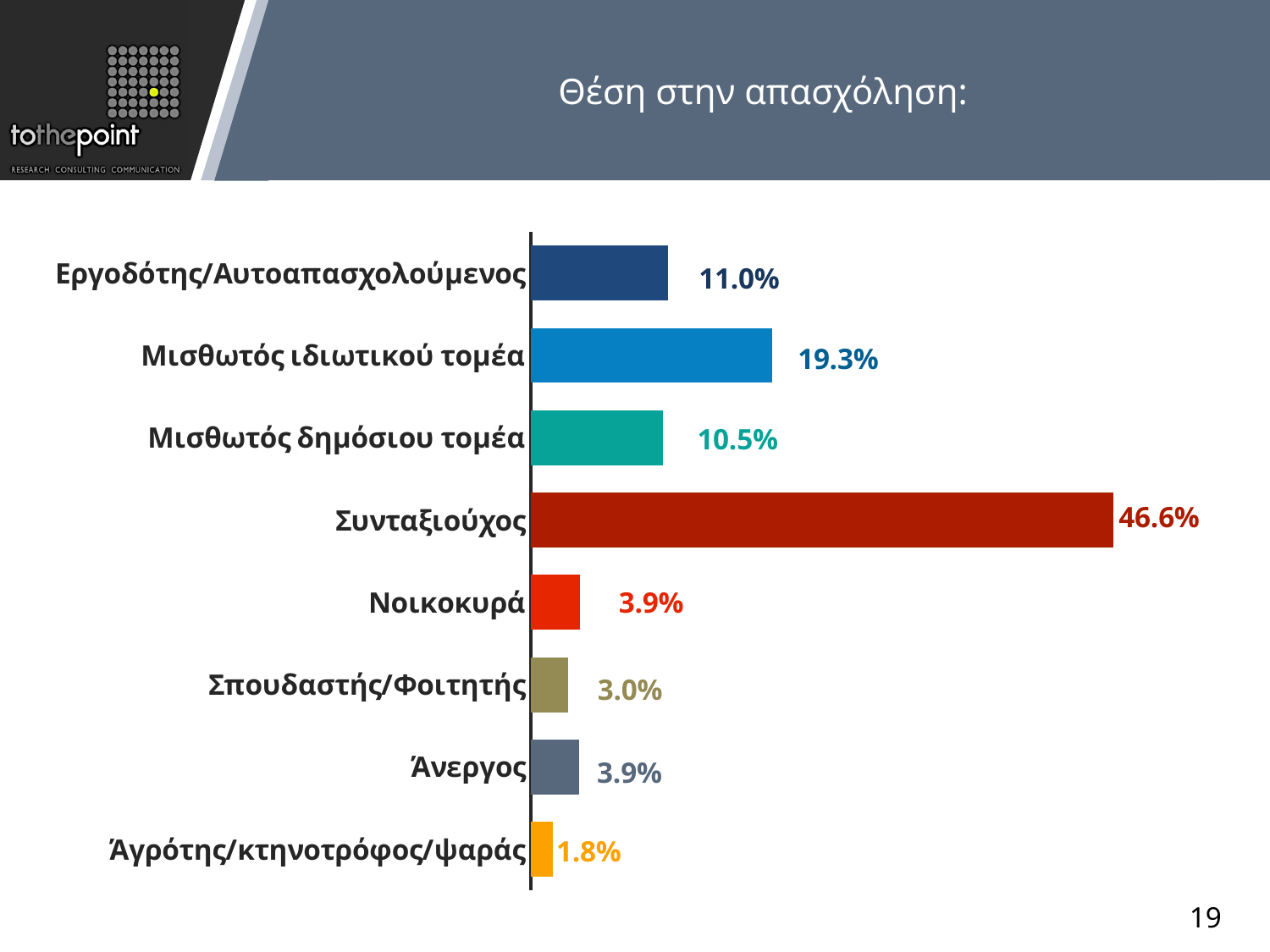
What is the value for Συνταξιούχος? 46.6% What is the value for Άγρότης/κτηνοτρόφος/ψαράς? 1.8% Which is larger, the value for Εργοδότης/Αυτοαπασχολούμενος or the value for Μισθωτός δημόσιου τομέα? Εργοδότης/Αυτοαπασχολούμενος How many categories are shown in the chart? 8 What is the title of the slide? Θέση στην απασχόληση: What is the difference between the values for Μισθωτός ιδιωτικού τομέα and Μισθωτός δημόσιου τομέα? 8.8% What kind of chart is shown on the slide? Bar chart Which category has the highest value? Συνταξιούχος What is the value for Μισθωτός ιδιωτικού τομέα? 19.3% What is the value for Εργοδότης/Αυτοαπασχολούμενος? 11.0% Which category has the lowest value? Άγρότης/κτηνοτρόφος/ψαράς What is the difference between the values for Συνταξιούχος and Νοικοκυρά? 42.7%